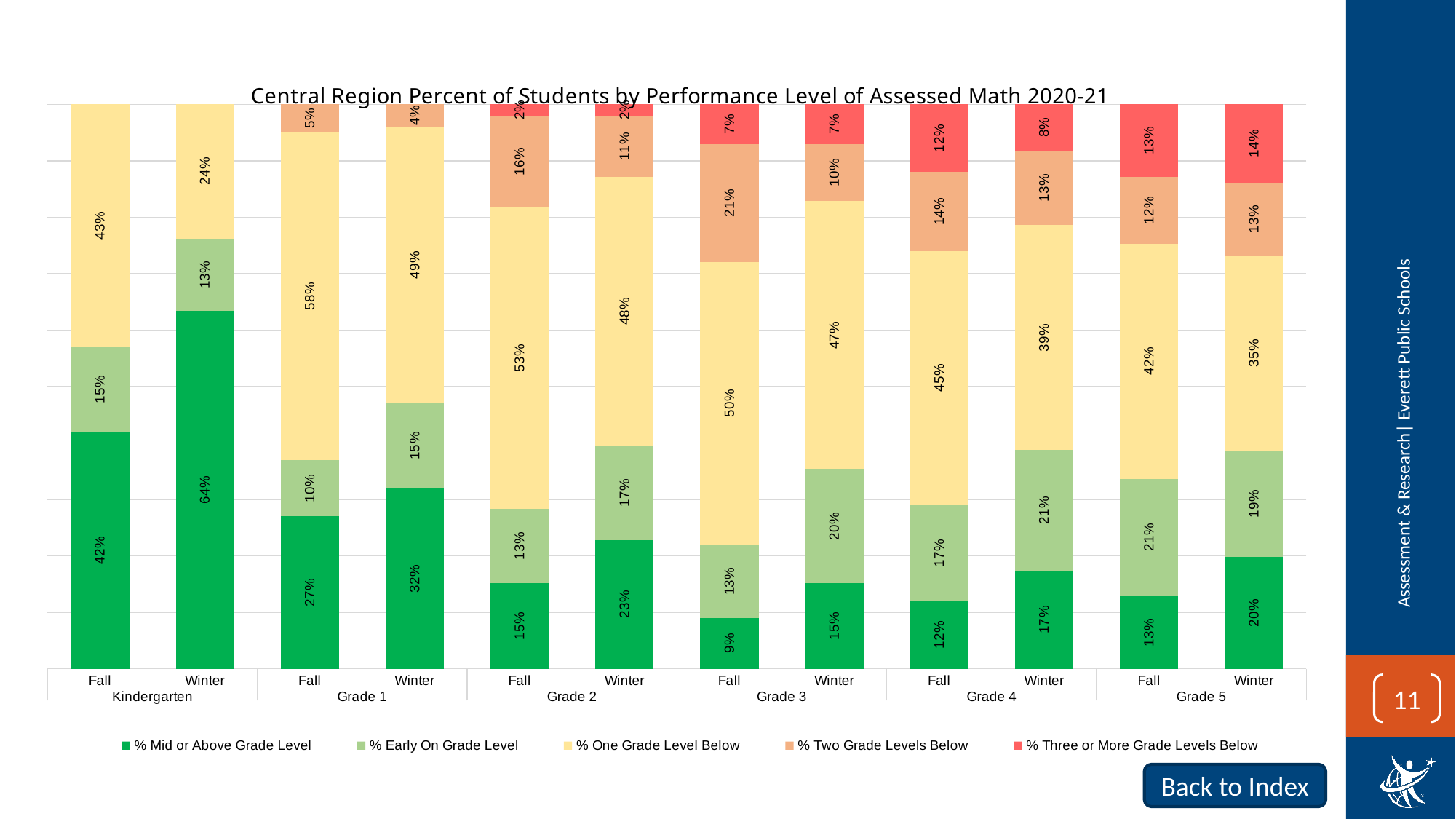
What percentage of Kindergarten students were Mid or Above Grade Level in Winter? 64% How many bars are plotted in the chart? 12 What percentage of Grade 5 students were One Grade Level Below in Winter? 35% What kind of chart is shown on the slide? Stacked bar chart Which is larger: the Three or More Grade Levels Below percentage for Grade 4 Fall or Grade 4 Winter? Grade 4 Fall What is the title of the chart? Central Region Percent of Students by Performance Level of Assessed Math 2020-21 What percentage of Grade 3 students were Two Grade Levels Below in Fall? 21% Does the Mid or Above Grade Level percentage rise or fall from Fall to Winter for Grade 1? Rise How many series does the legend list? 5 How much higher is the Mid or Above Grade Level percentage for Grade 2 in Winter than in Fall? 8% Which bar has the highest percentage of students Mid or Above Grade Level? Kindergarten Winter Which bar has the lowest percentage of students Mid or Above Grade Level? Grade 3 Fall